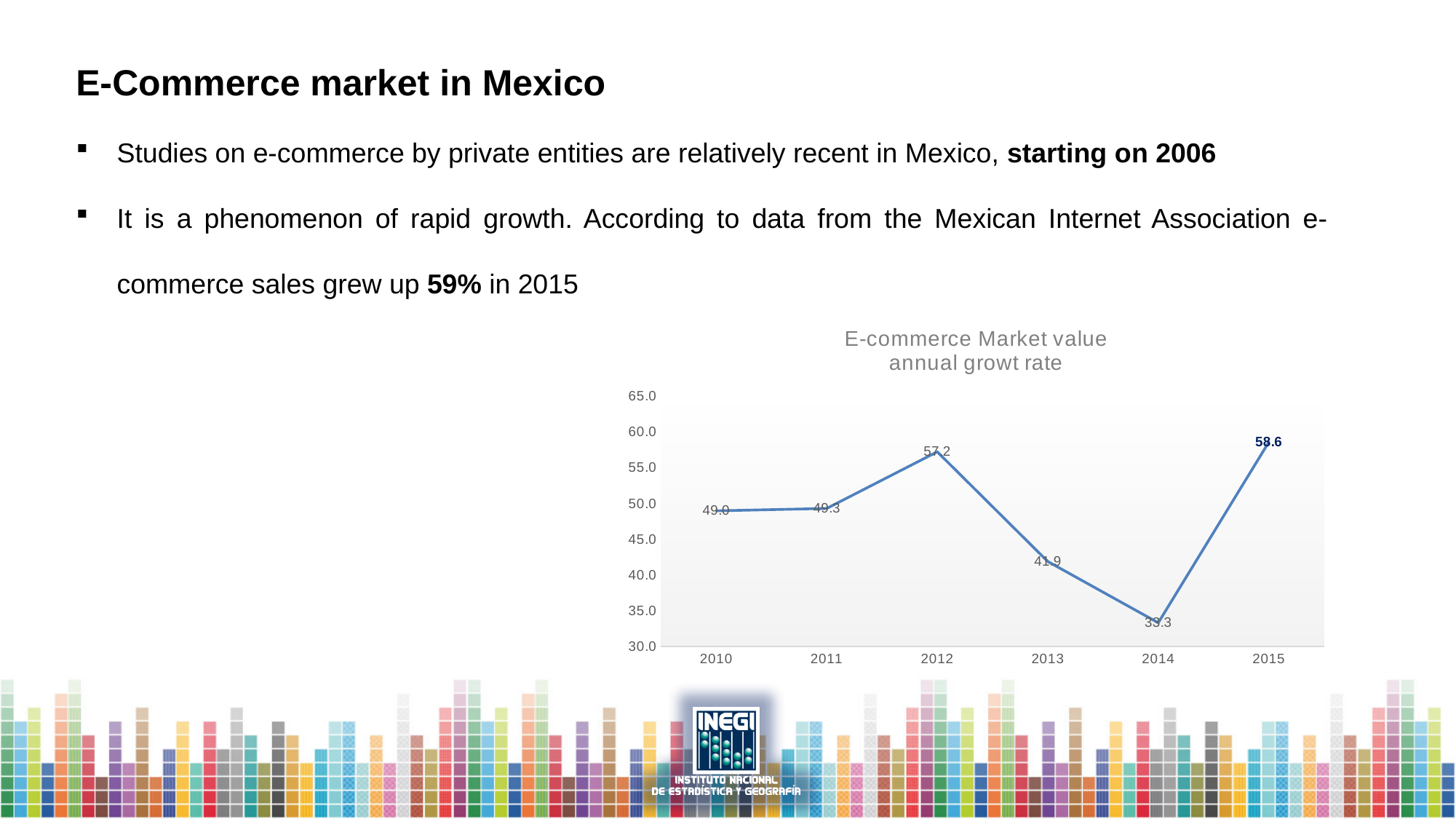
How many years are plotted on the x axis? 6 What is the value for 2015? 58.6 What is the difference between the values for 2015 and 2014? 25.3 What is the title of the chart? E-commerce Market value annual growt rate Is the value for 2013 greater or less than 45.0? less Which year has the lowest value? 2014 Which is larger, the value for 2012 or the value for 2013? 2012 What is the value for 2012? 57.2 What is the value for 2014? 33.3 What type of chart is shown on the slide? line chart What is the value for 2010? 49.0 Which year has the highest value? 2015